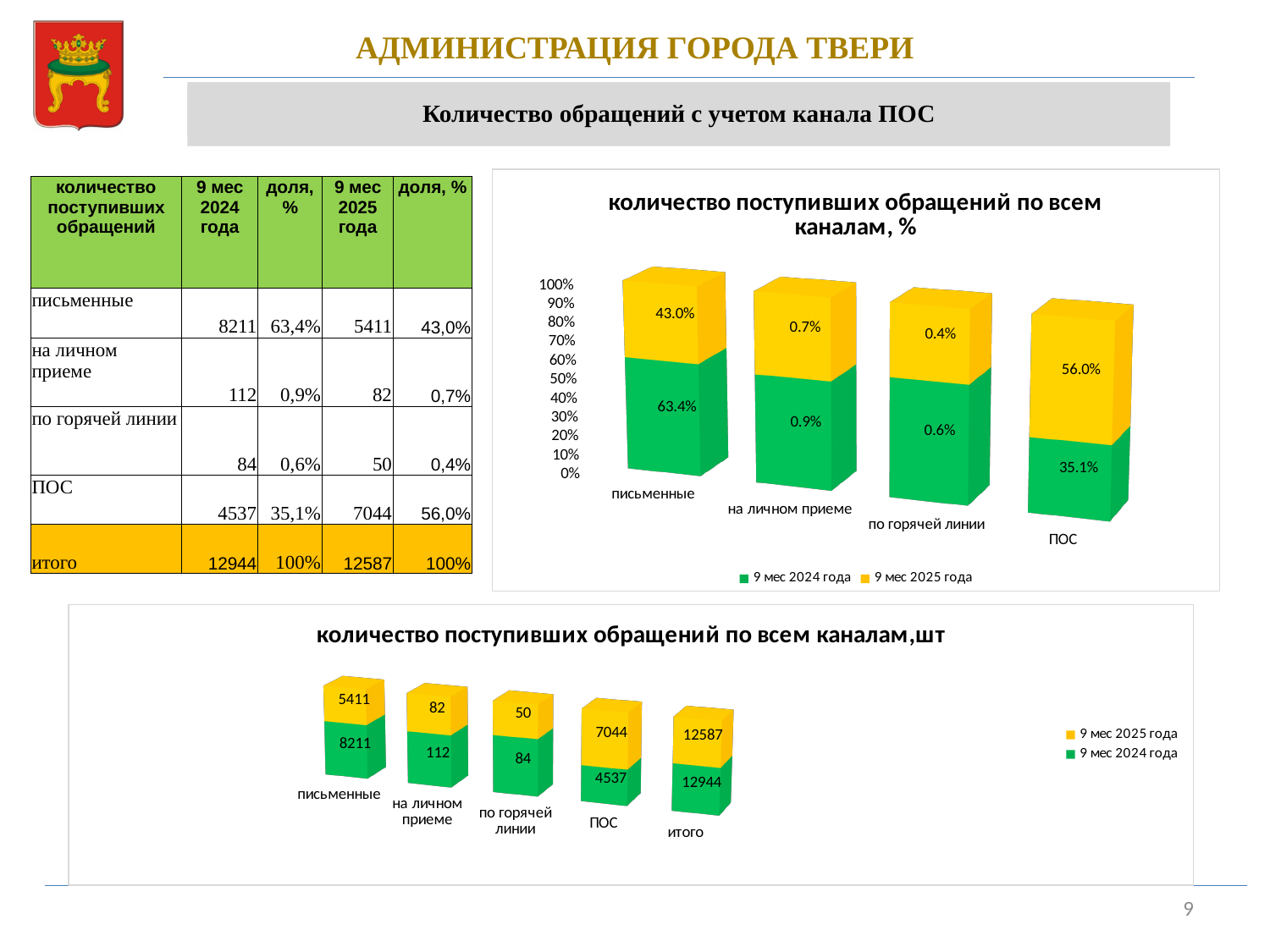
In the chart titled "количество поступивших обращений по всем каналам,шт", what is the value for письменные in the 9 мес 2024 года series? 8211 How many categories are shown on the x axis of the chart titled "количество поступивших обращений по всем каналам,шт"? 5 In the chart titled "количество поступивших обращений по всем каналам, %", what is the value for по горячей линии in the 9 мес 2024 года series? 0.6% In the chart titled "количество поступивших обращений по всем каналам,шт", what is the total of the stacked bar for на личном приеме? 194 In the chart titled "количество поступивших обращений по всем каналам,шт", what is the difference between the 9 мес 2025 года and 9 мес 2024 года values for ПОС? 2507 In the chart titled "количество поступивших обращений по всем каналам,шт", which category has the lowest value in the 9 мес 2024 года series? по горячей линии In the chart titled "количество поступивших обращений по всем каналам,шт", which category has the highest value in the 9 мес 2025 года series? итого In the chart titled "количество поступивших обращений по всем каналам, %", what is the value for ПОС in the 9 мес 2025 года series? 56.0% In the chart titled "количество поступивших обращений по всем каналам,шт", for письменные, which series has the larger value: 9 мес 2024 года or 9 мес 2025 года? 9 мес 2024 года What kind of chart is the chart titled "количество поступивших обращений по всем каналам, %"? Stacked bar chart How many categories are shown on the x axis of the chart titled "количество поступивших обращений по всем каналам, %"? 4 How many series does the legend of the chart titled "количество поступивших обращений по всем каналам,шт" list? 2